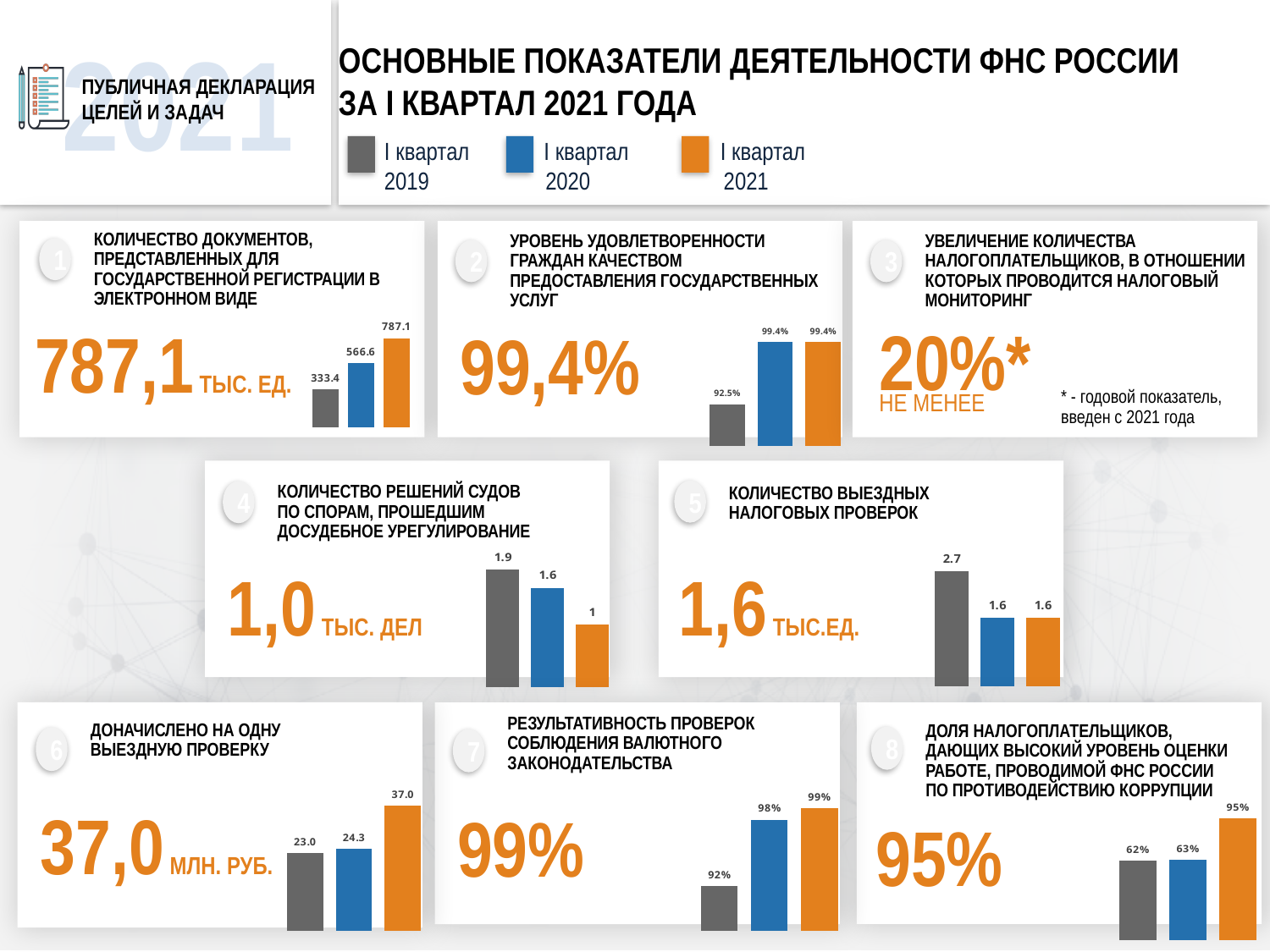
In the chart for indicator 6 (доначислено на одну выездную проверку), what is the value for I квартал 2020? 24.3 In the chart for indicator 6 (доначислено на одну выездную проверку), which period has the lowest value? I квартал 2019 In the chart for indicator 4 (количество решений судов по спорам, прошедшим досудебное урегулирование), which period has the highest value? I квартал 2019 In the chart for indicator 4 (количество решений судов по спорам, прошедшим досудебное урегулирование), do the values rise or fall from I квартал 2019 to I квартал 2021? fall In the chart for indicator 5 (количество выездных налоговых проверок), what is the difference between the I квартал 2019 and I квартал 2020 values? 1.1 In the chart for indicator 8 (доля налогоплательщиков, дающих высокий уровень оценки работе по противодействию коррупции), what is the value for I квартал 2021? 95% In the chart for indicator 7 (результативность проверок соблюдения валютного законодательства), which is larger: the value for I квартал 2020 or I квартал 2019? I квартал 2020 In the chart for indicator 1 (количество документов, представленных для государственной регистрации в электронном виде), what is the difference between the I квартал 2021 and I квартал 2020 values? 220.5 How many series does the legend at the top of the slide list? 3 In the chart for indicator 5 (количество выездных налоговых проверок), what is the value for I квартал 2019? 2.7 In the chart for indicator 1 (количество документов, представленных для государственной регистрации в электронном виде), what is the value for I квартал 2019? 333.4 In the chart for indicator 2 (уровень удовлетворенности граждан качеством предоставления государственных услуг), what is the value for I квартал 2019? 92.5%